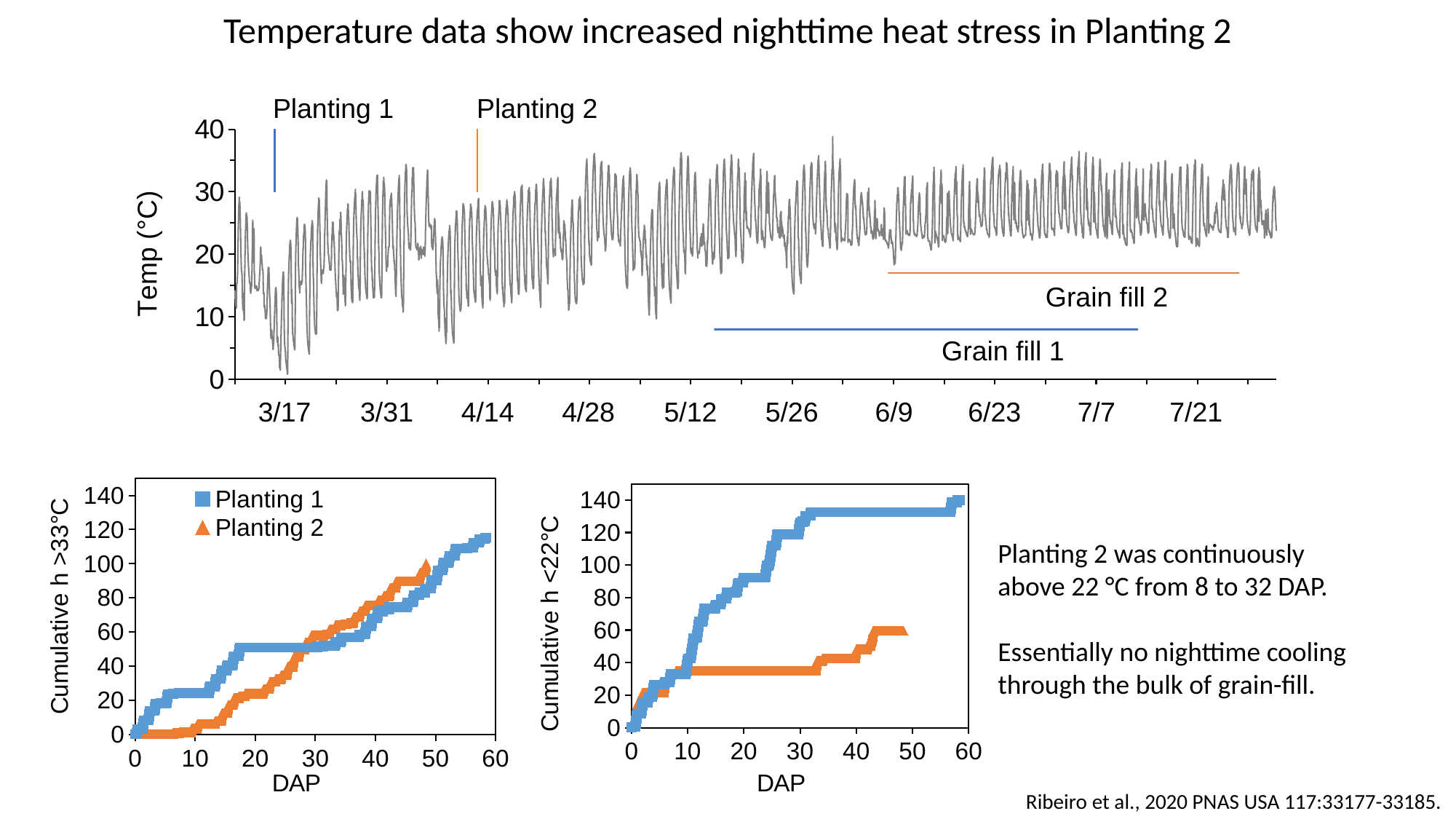
In the top temperature chart, how many date tick labels are shown on the x axis? 10 In the bottom-right chart (Cumulative h <22°C), is the value for Planting 2 at 45 DAP greater or less than 80? less In the bottom-right chart (Cumulative h <22°C), which series is higher at 30 DAP, Planting 1 or Planting 2? Planting 1 In the bottom-right chart (Cumulative h <22°C), is the value for Planting 1 at 40 DAP greater or less than 120? greater What kind of chart is the top chart showing Temp (°C) over dates? line chart In the top temperature chart, what is the highest value shown on the y axis? 40 In the bottom-left chart (Cumulative h >33°C), do the values for Planting 1 rise or fall as DAP increases? rise In the bottom-left chart (Cumulative h >33°C), is the value for Planting 2 at 25 DAP greater or less than 40? less In the bottom-left chart (Cumulative h >33°C), how many series does the legend list? 2 In the bottom-left chart (Cumulative h >33°C), which series is higher at 10 DAP, Planting 1 or Planting 2? Planting 1 In the bottom-left chart, which colour represents Planting 2? orange